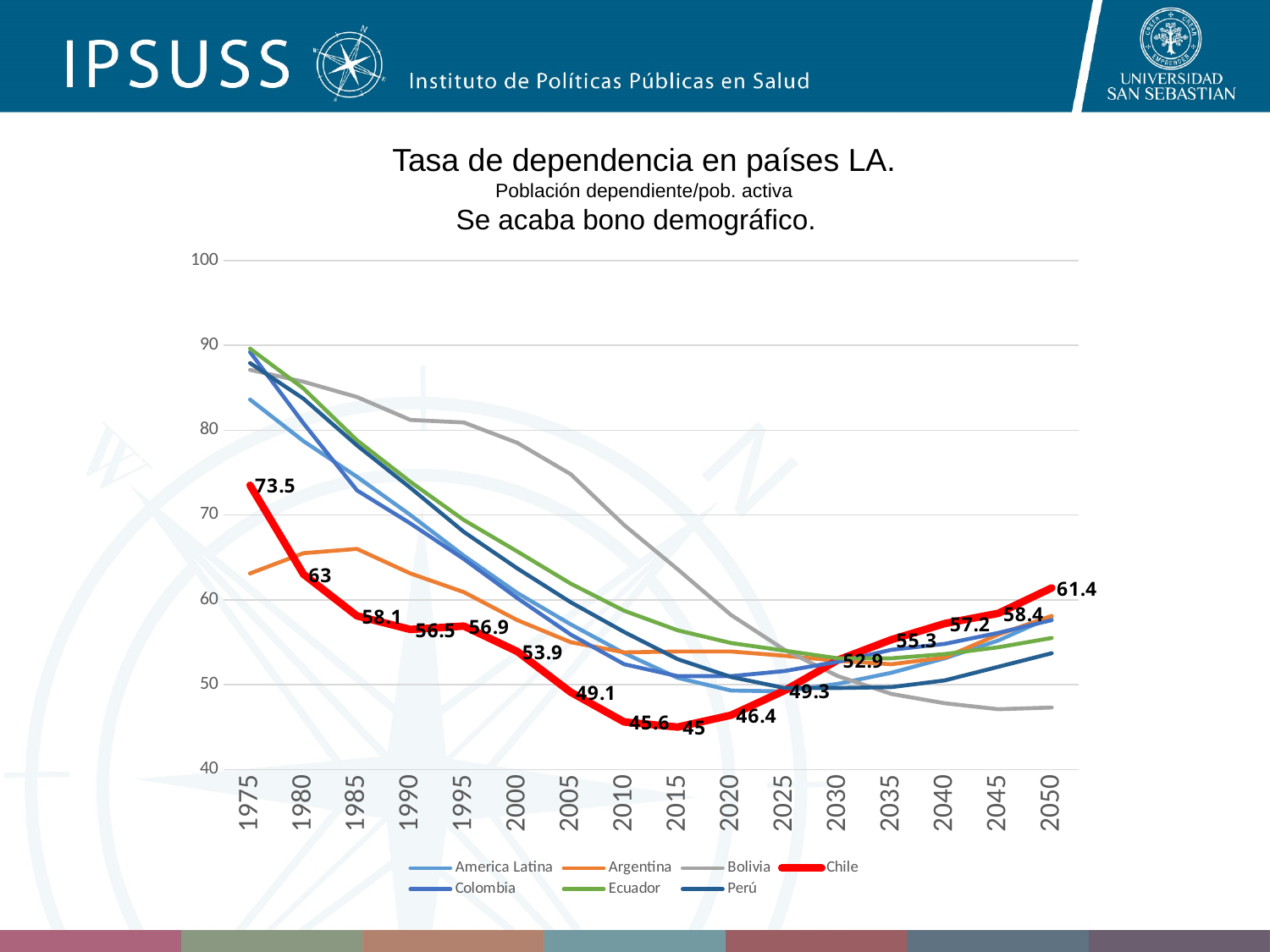
Is the value for Ecuador in 1975 greater or less than 80? greater Is the value for Bolivia in 2050 greater or less than 50? less In which year does the Chile series reach its highest value? 1975 Which is larger for Chile: the value in 1980 or the value in 2050? 1980 What is the difference between the Chile values in 1975 and 2050? 12.1 In which year does the Chile series reach its lowest value? 2015 What is the value for Chile in 2050? 61.4 What is the value for Chile in 2015? 45 What is the value for Chile in 1975? 73.5 What kind of chart is shown on the slide? Line chart How many years are shown on the x axis? 16 How many series does the legend list? 7